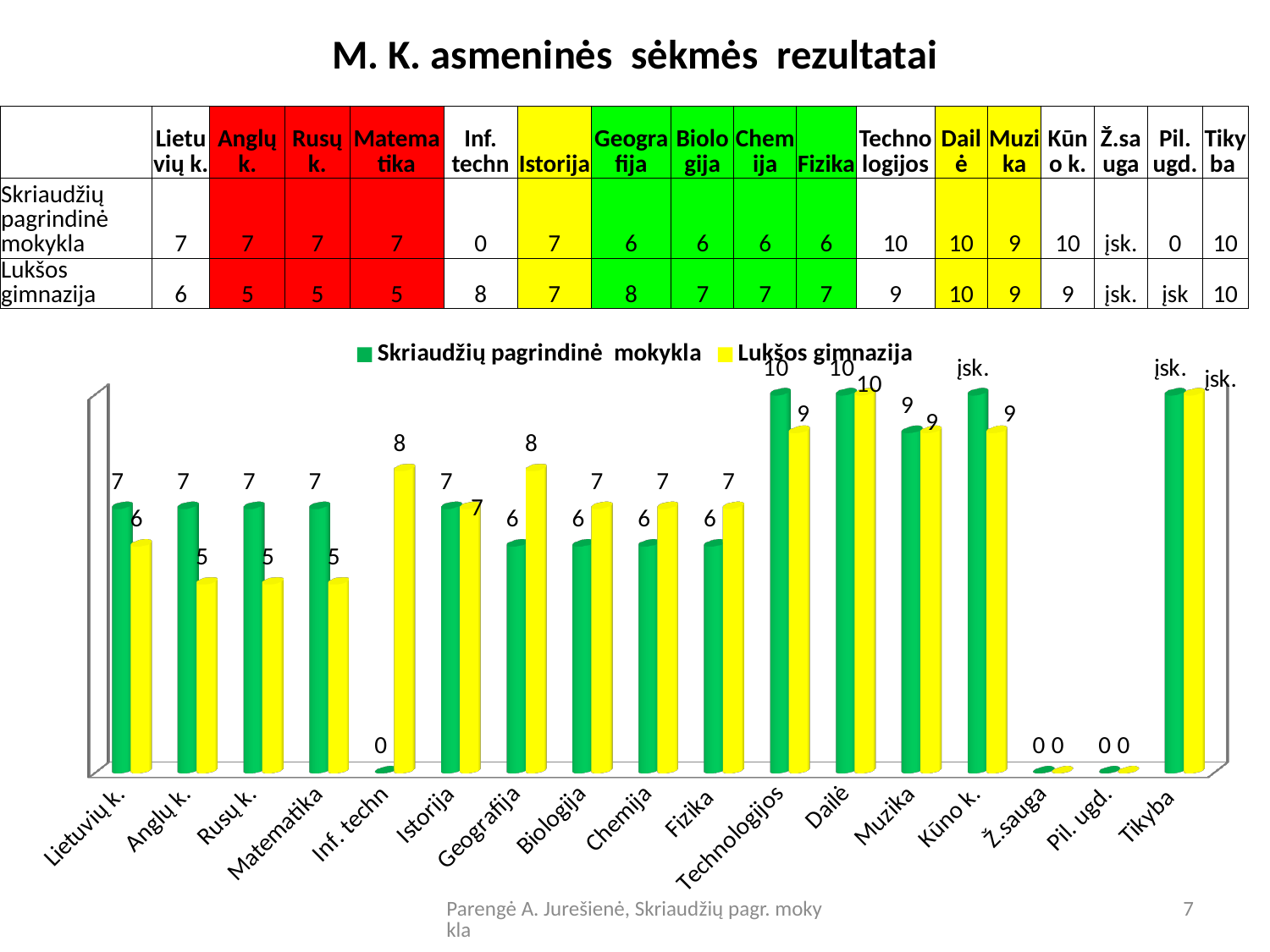
How many subject categories are shown on the x axis of the chart? 17 How many series does the chart legend list? 2 What type of chart is shown on the slide? bar chart In the chart, what is the value for Skriaudžių pagrindinė mokykla in Technologijos? 10 In the chart, which series has the larger value for Inf. techn? Lukšos gimnazija In the chart, what is the value for Skriaudžių pagrindinė mokykla in Inf. techn? 0 Which series in the chart is shown in yellow? Lukšos gimnazija In the chart, what is the value for Skriaudžių pagrindinė mokykla in Geografija? 6 In the chart, what is the difference between the Skriaudžių pagrindinė mokykla and Lukšos gimnazija values for Matematika? 2 In the chart, what is the value for Lukšos gimnazija in Inf. techn? 8 In the chart, which series has the larger value for Biologija? Lukšos gimnazija In the chart, what is the value for Lukšos gimnazija in Anglų k.? 5